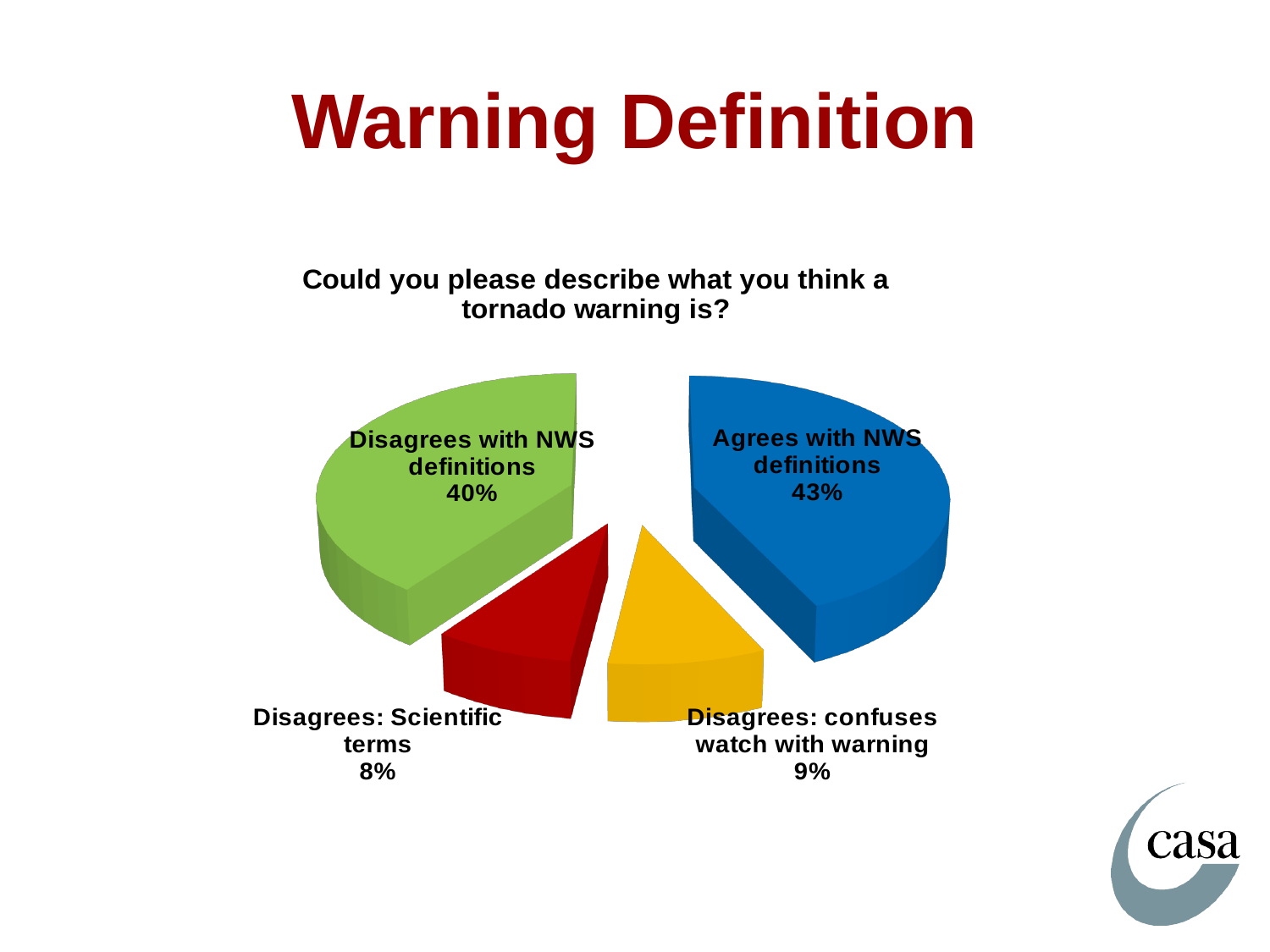
Which is larger: the share for 'Disagrees: confuses watch with warning' or the share for 'Disagrees: Scientific terms'? Disagrees: confuses watch with warning What kind of chart is shown on the slide? pie chart What is the difference between the 'Agrees with NWS definitions' share and the 'Disagrees with NWS definitions' share? 3% What is the combined share of the three 'Disagrees' categories? 57% What colour is the 'Agrees with NWS definitions' slice? blue What is the share for 'Disagrees: Scientific terms'? 8% Which category has the smallest share of the pie? Disagrees: Scientific terms What is the share for 'Disagrees: confuses watch with warning'? 9% What percentage of respondents agrees with NWS definitions? 43% How many slices does the pie chart have? 4 What percentage of respondents disagrees with NWS definitions? 40% Which category has the largest share of the pie? Agrees with NWS definitions